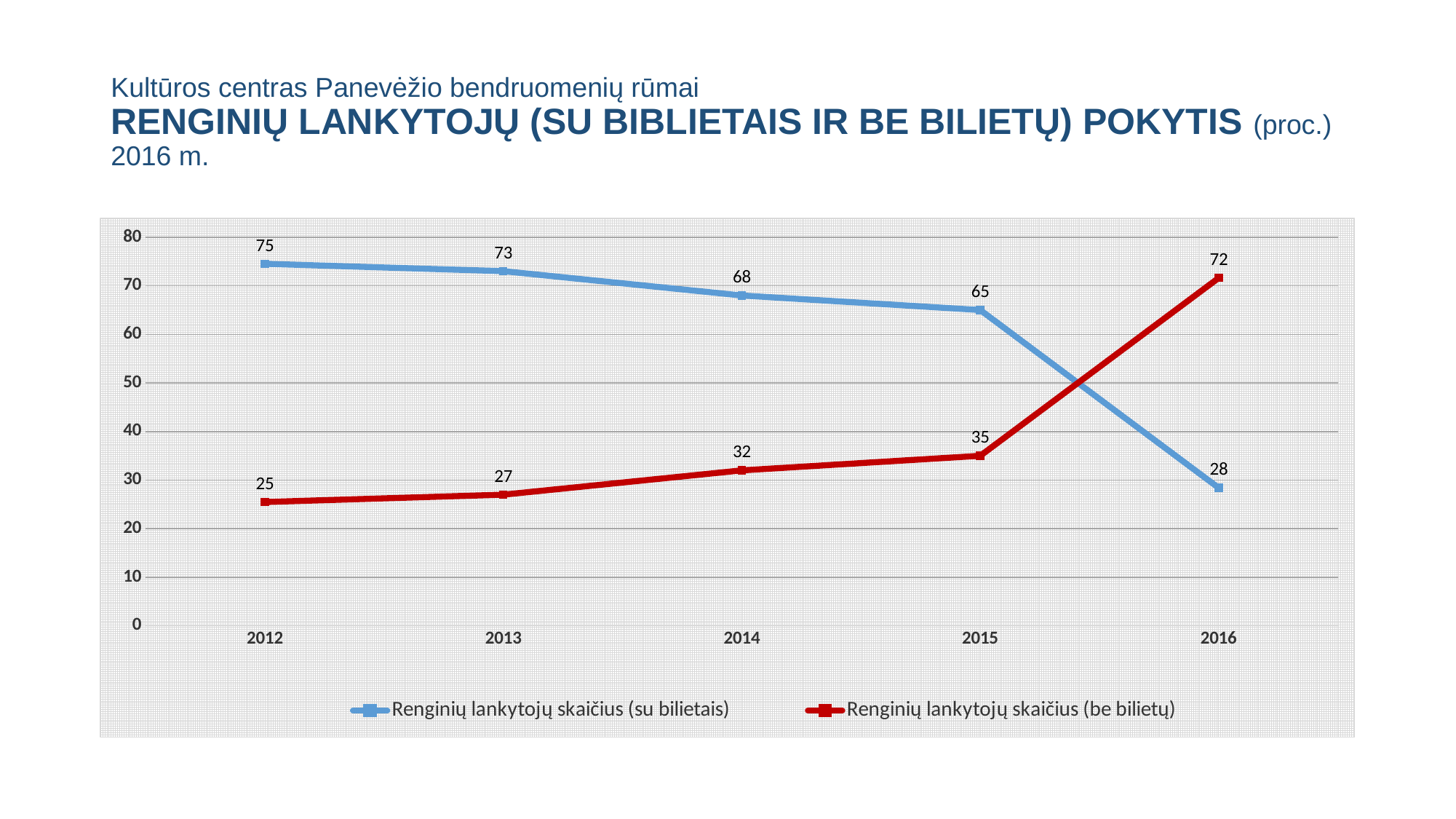
What is the difference between the 'su bilietais' and 'be bilietų' values in 2015? 30 Does the 'Renginių lankytojų skaičius (be bilietų)' series rise or fall from 2012 to 2016? Rise What colour is the line for 'Renginių lankytojų skaičius (su bilietais)'? Blue How many series does the legend list? 2 What kind of chart is shown on the slide? Line chart In which year is 'Renginių lankytojų skaičius (be bilietų)' highest? 2016 In which year is 'Renginių lankytojų skaičius (su bilietais)' lowest? 2016 What is the value for 'Renginių lankytojų skaičius (be bilietų)' in 2016? 72 How many years are shown on the x axis? 5 Which series has the larger value in 2016, 'su bilietais' or 'be bilietų'? be bilietų What is the value for 'Renginių lankytojų skaičius (su bilietais)' in 2012? 75 What is the value for 'Renginių lankytojų skaičius (be bilietų)' in 2014? 32